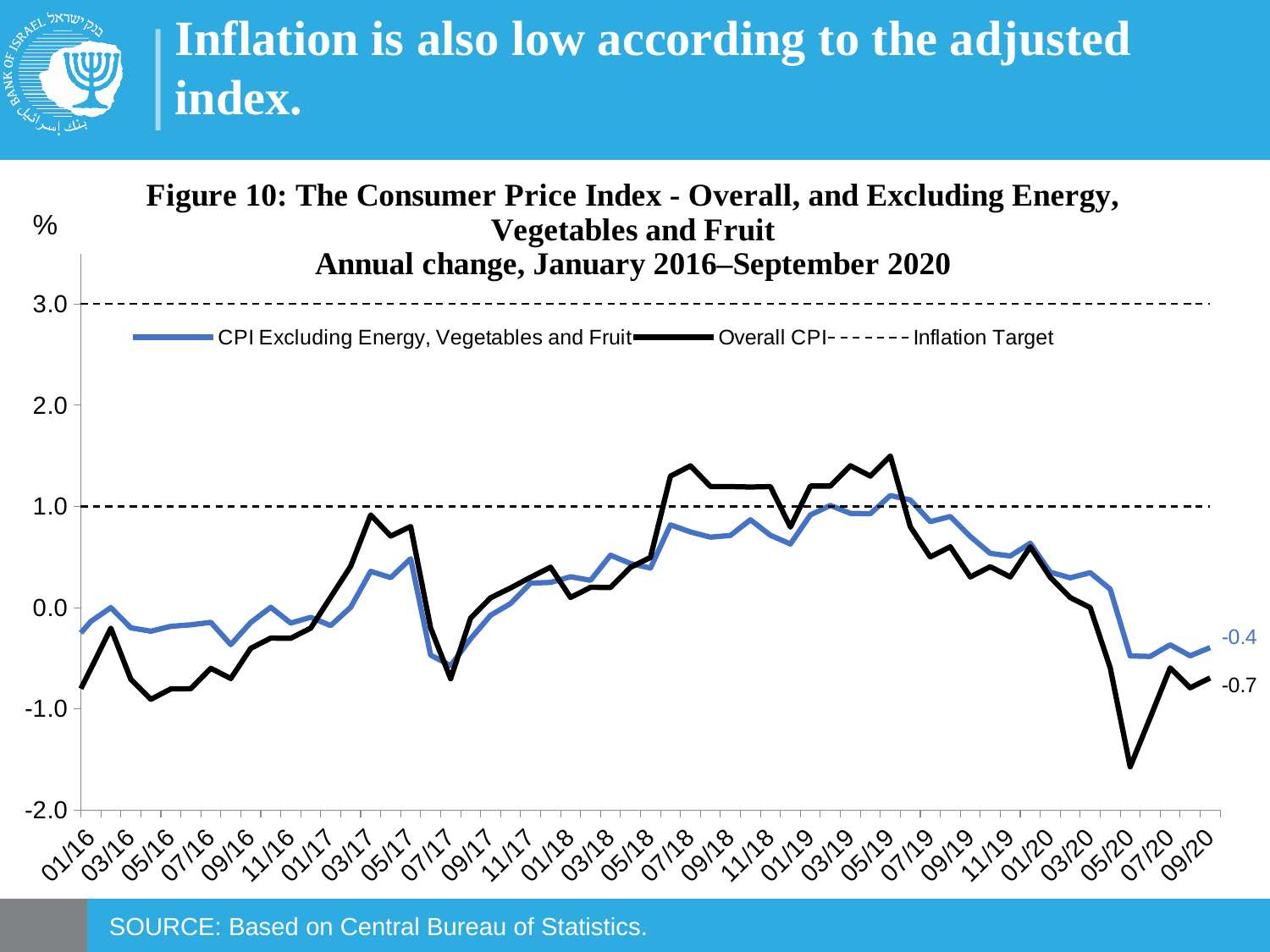
What is the difference between the final labelled values of CPI Excluding Energy, Vegetables and Fruit (-0.4) and Overall CPI (-0.7)? 0.3 What does the dashed line in the chart represent, according to the legend? Inflation Target How many entries does the legend list? 3 What period does the chart cover, according to its title? January 2016–September 2020 What is the value of Overall CPI at the end of the series (09/20)? -0.7 What kind of chart is shown in Figure 10? line chart At 09/20, which series is higher: CPI Excluding Energy, Vegetables and Fruit or Overall CPI? CPI Excluding Energy, Vegetables and Fruit Is the value for CPI Excluding Energy, Vegetables and Fruit in 07/17 greater or less than 0.0? less Between 03/20 and 05/20, does the Overall CPI line rise or fall? fall Is the value for Overall CPI in 05/20 greater or less than -1.0? less Is the value for Overall CPI in 05/19 greater or less than 1.0? greater What is the value of CPI Excluding Energy, Vegetables and Fruit at the end of the series (09/20)? -0.4